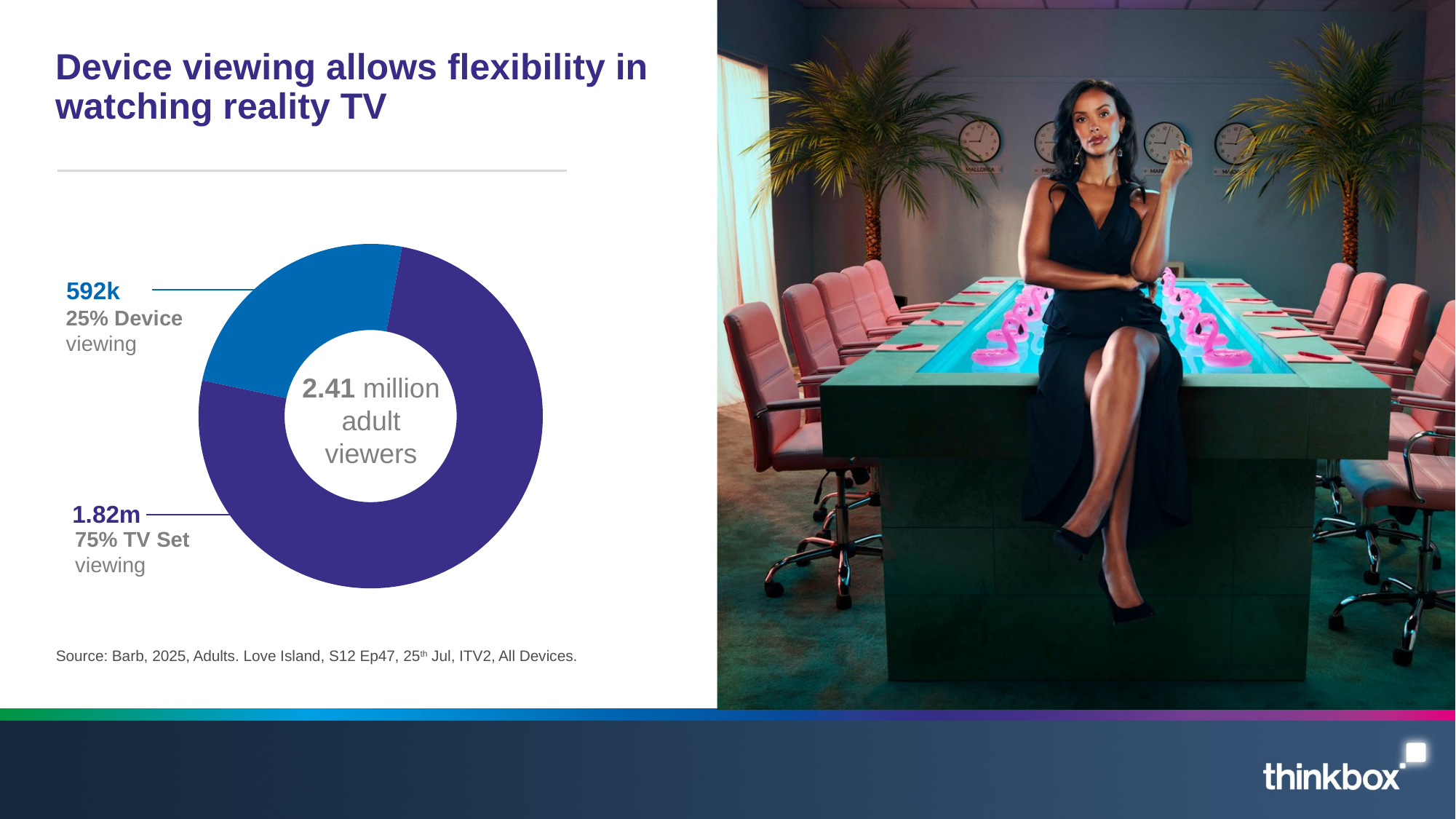
What is the value for TV Set viewing? 1.82m How many adult viewers does the centre of the doughnut chart report? 2.41 million Which segment of the doughnut chart is the smallest? Device viewing What colour is the Device viewing segment? Blue What share of viewing is TV Set viewing? 75% What is the value for Device viewing? 592k How many segments does the doughnut chart have? 2 What kind of chart is shown on the slide? Doughnut (pie) chart Which segment is larger, Device viewing or TV Set viewing? TV Set viewing What share of viewing is Device viewing? 25% What is the difference in percentage points between TV Set viewing and Device viewing? 50 percentage points What is the source cited for the chart? Barb, 2025, Adults. Love Island, S12 Ep47, 25th Jul, ITV2, All Devices.